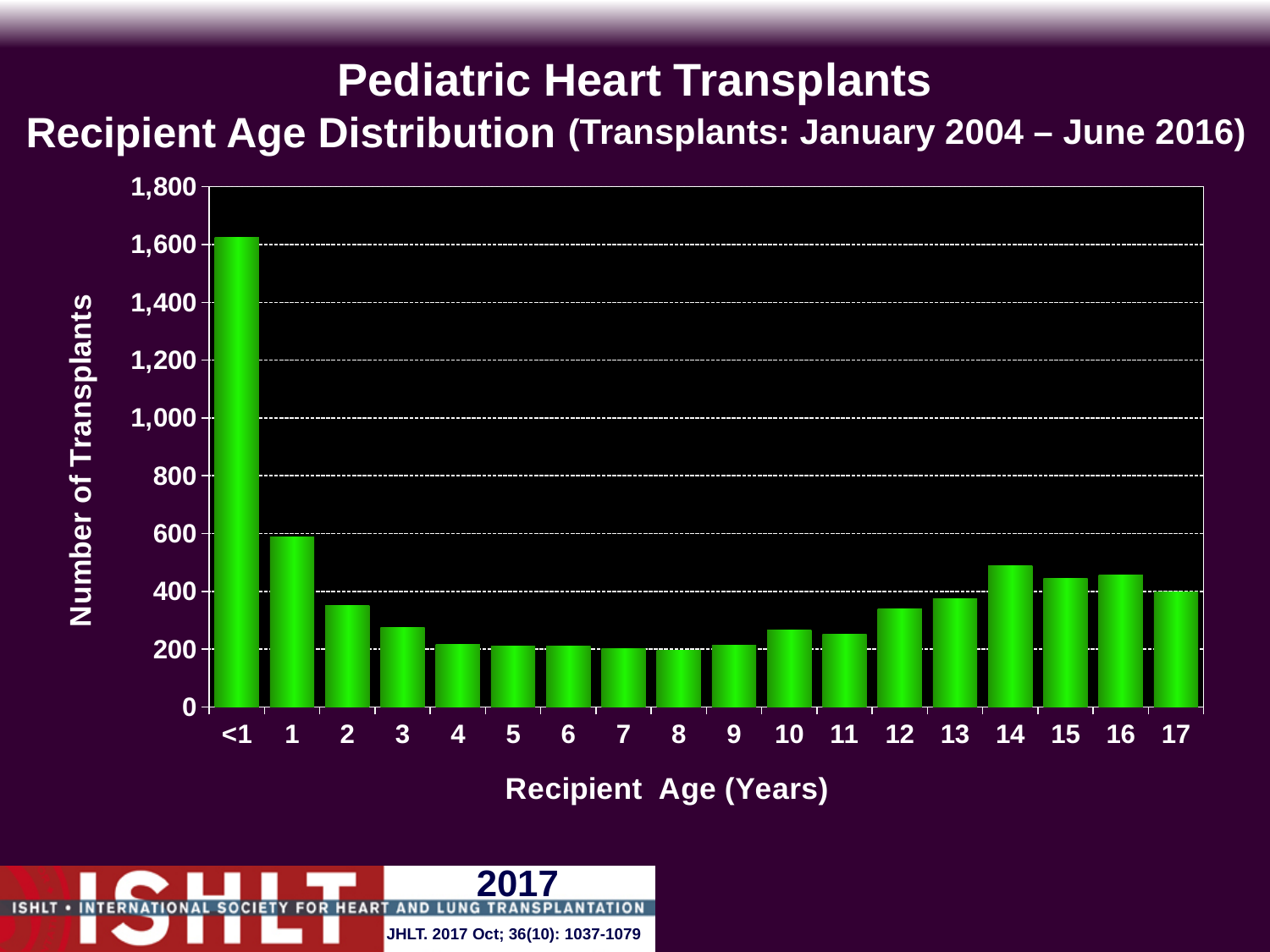
What kind of chart is shown on the slide? bar chart What is the title of the y axis? Number of Transplants Is the number of transplants for recipients aged 2 greater or less than 400? less Which has more transplants: recipients aged 13 or recipients aged 14? 14 Is the number of transplants for recipients aged 14 greater or less than 400? greater Which has more transplants: recipients aged 1 or recipients aged 2? 1 How many recipient age categories are shown on the x axis? 18 Do the number of transplants rise or fall from age 1 to age 7? fall Which recipient age category has the highest number of transplants? <1 Is the number of transplants for recipients aged 1 greater or less than 400? greater